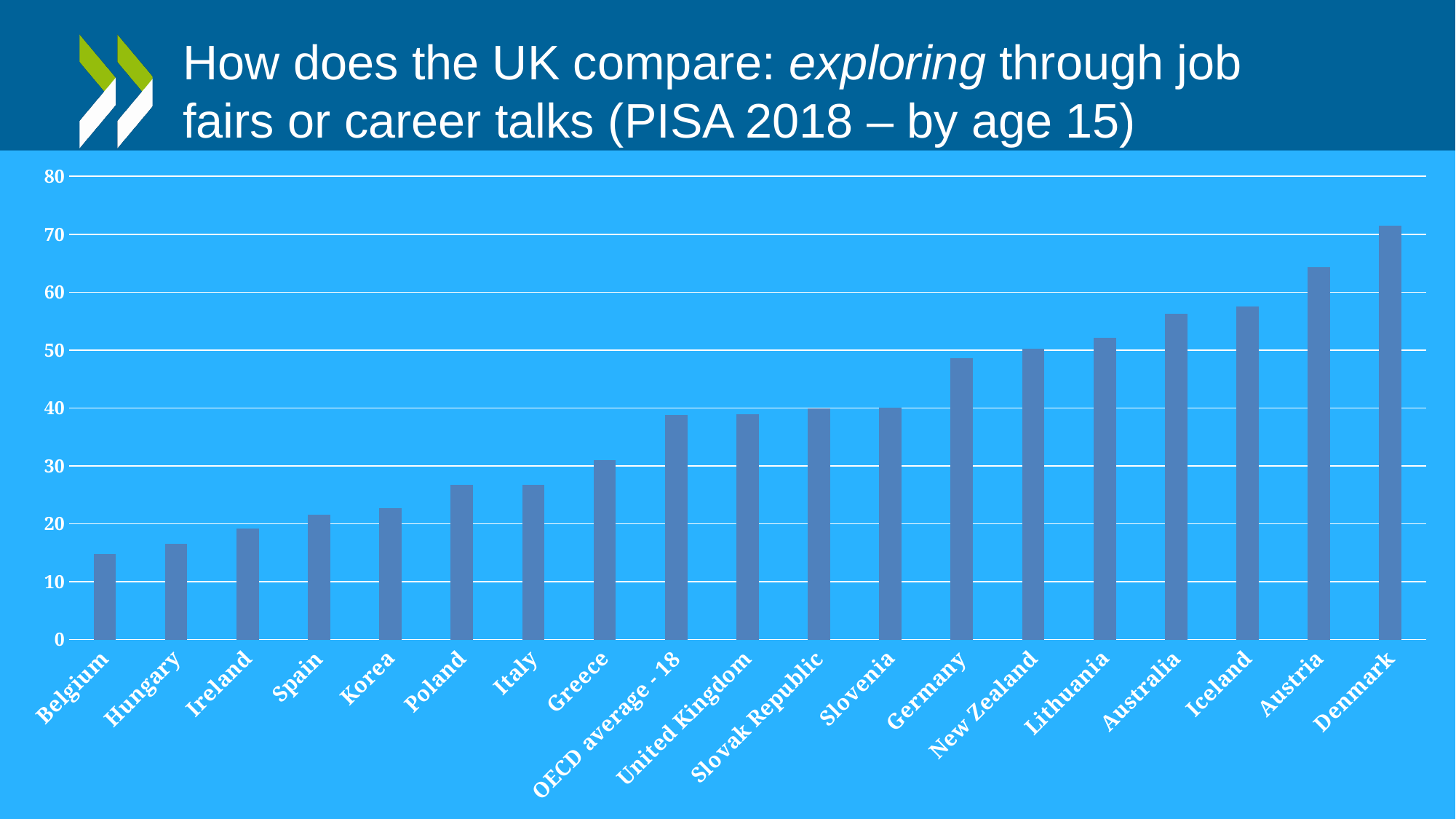
Is the value for Greece greater or less than 30? greater Do the bar values generally rise or fall from left to right along the x axis? Rise Which country has the lowest bar in the chart? Belgium Is the value for Austria greater or less than 60? greater Which country has the highest bar in the chart? Denmark Is the value for Denmark greater or less than 70? greater How many categories are shown along the x axis? 19 Which has a larger value, Austria or Iceland? Austria What is the highest value shown on the y axis? 80 What kind of chart is shown on the slide? Bar chart